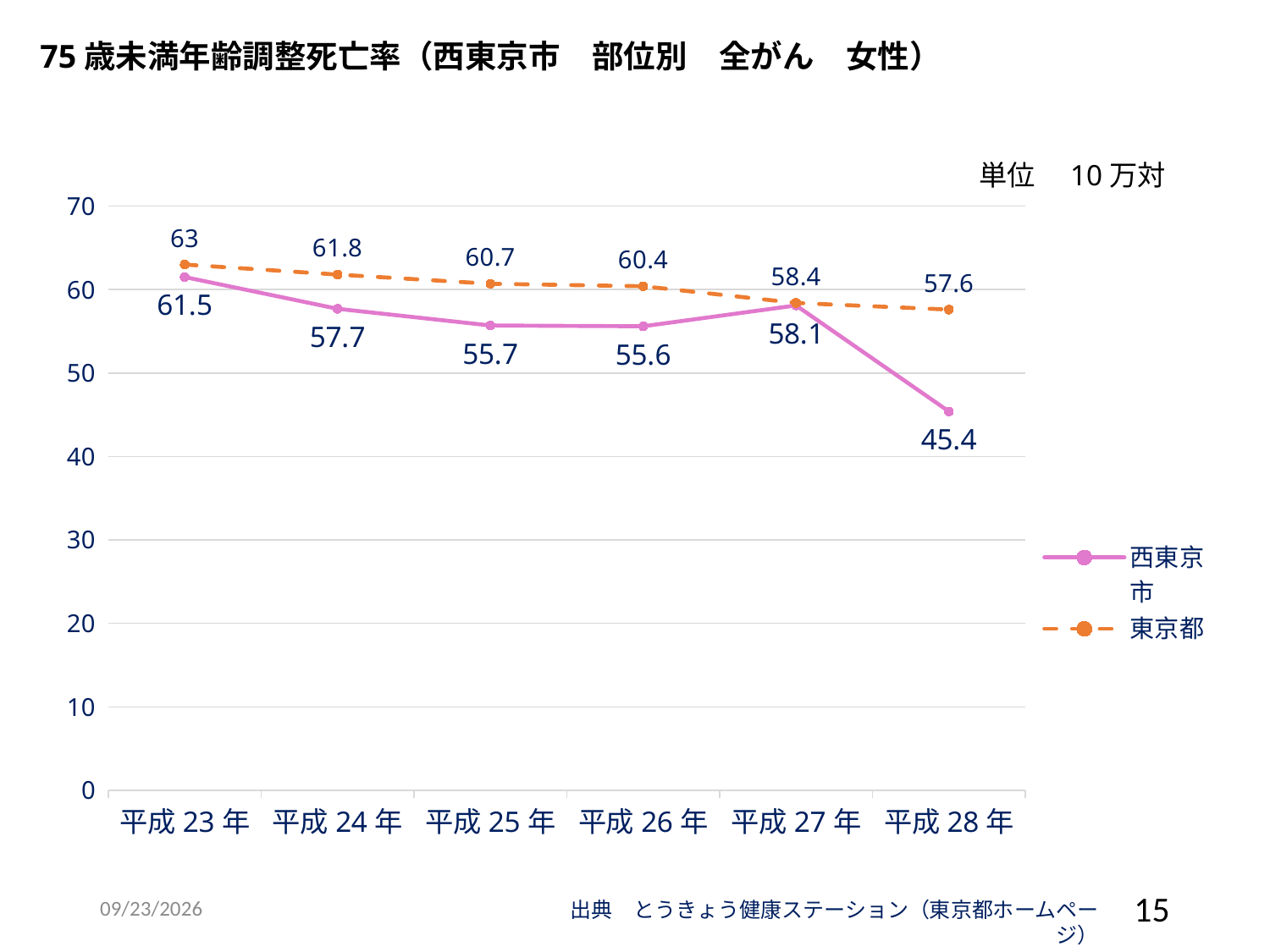
What is the value for 東京都 in 平成27年? 58.4 What is the value for 東京都 in 平成23年? 63 What is the value for 西東京市 in 平成25年? 55.7 In which year is the value for 東京都 highest? 平成23年 In which year is the value for 西東京市 lowest? 平成28年 What is the difference between 東京都 and 西東京市 in 平成28年? 12.2 What kind of chart is this? line chart How many years are shown on the x axis? 6 Does the value for 東京都 rise or fall from 平成23年 to 平成28年? fall How many series does the legend list? 2 Which is larger in 平成24年, 西東京市 or 東京都? 東京都 What is the value for 西東京市 in 平成28年? 45.4